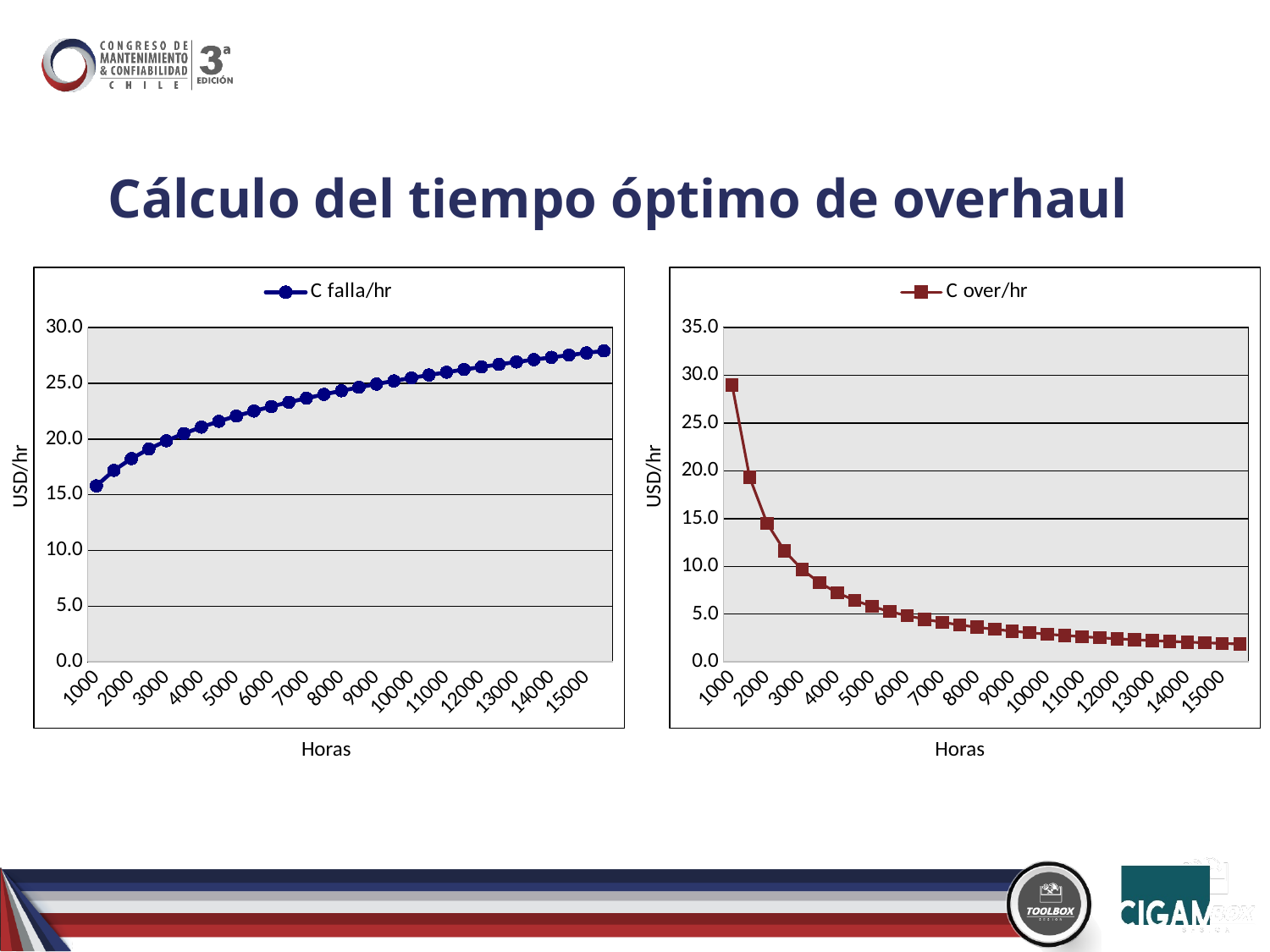
In the right chart (C over/hr), is the value at 1000 hours greater or less than 25.0? greater What is the label on the y axis of the left chart (C falla/hr)? USD/hr In the left chart (C falla/hr), which is larger: the value at 3000 hours or the value at 10000 hours? 10000 hours In the right chart (C over/hr), at which hour value on the x axis is the series highest? 1000 In the left chart (C falla/hr), is the value at 15000 hours greater or less than 25.0? greater In the left chart (C falla/hr), at which hour value on the x axis is the series lowest? 1000 How many series does the legend of the right chart (C over/hr) list? 1 In the left chart (C falla/hr), do the values rise or fall as the hours increase along the x axis? rise In the left chart (C falla/hr), is the value at 1000 hours greater or less than 20.0? less In the right chart (C over/hr), do the values rise or fall as the hours increase along the x axis? fall What kind of chart is the left chart titled 'C falla/hr'? line chart